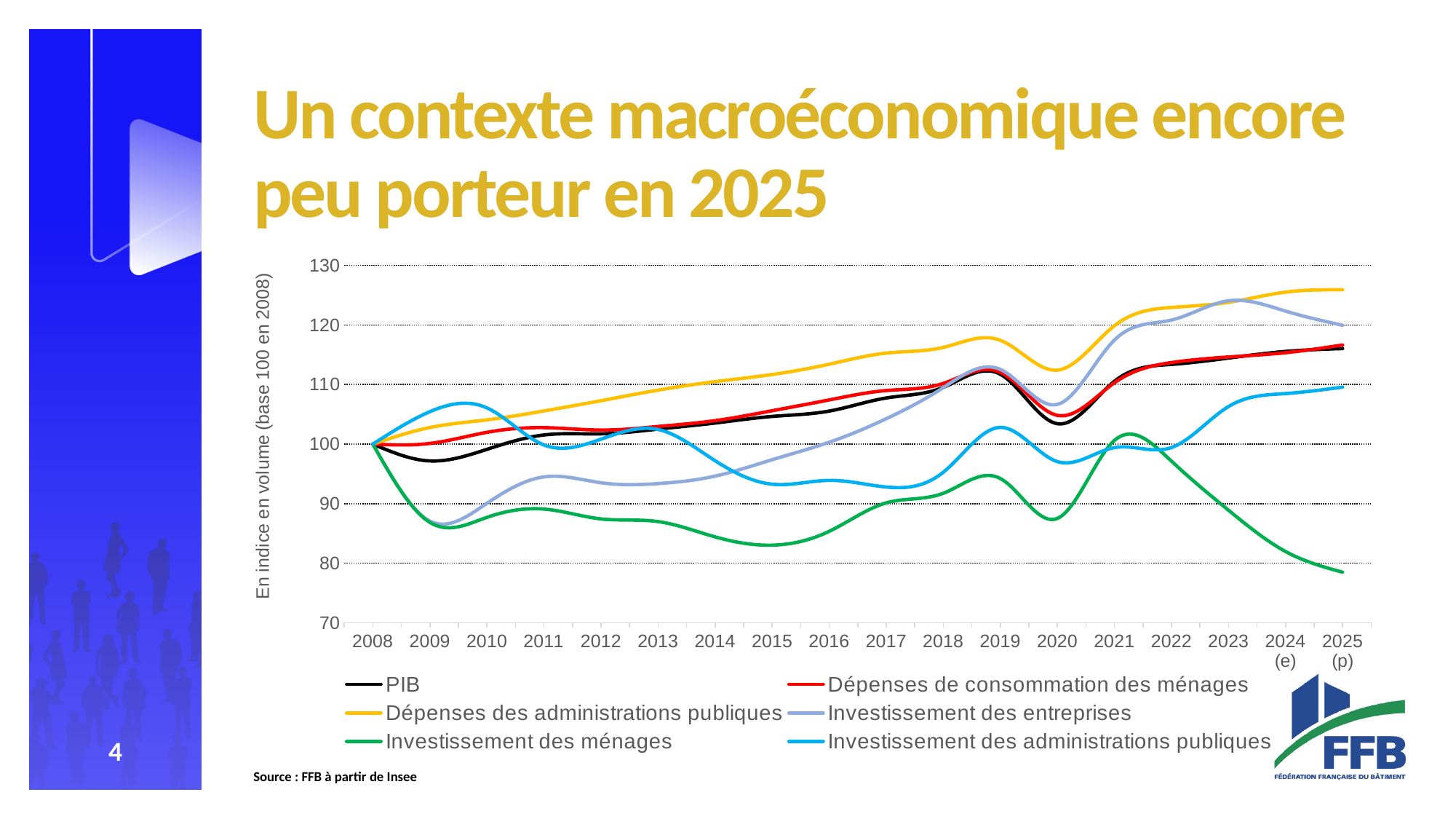
Is the value for Investissement des ménages in 2025 (p) greater or less than 80? less What is the value of PIB in 2008? 100 What is the label of the vertical axis? En indice en volume (base 100 en 2008) Is the value for PIB in 2020 greater or less than 110? less Is the value for Dépenses des administrations publiques in 2025 (p) greater or less than 120? greater Does Investissement des ménages rise or fall between 2021 and 2025 (p)? fall Which series has the lowest value in 2025 (p)? Investissement des ménages In 2025 (p), which is larger: Investissement des entreprises or Investissement des ménages? Investissement des entreprises How many years are shown on the x axis? 18 What kind of chart is shown on the slide? line chart Which series has the highest value in 2025 (p)? Dépenses des administrations publiques How many series does the legend list? 6